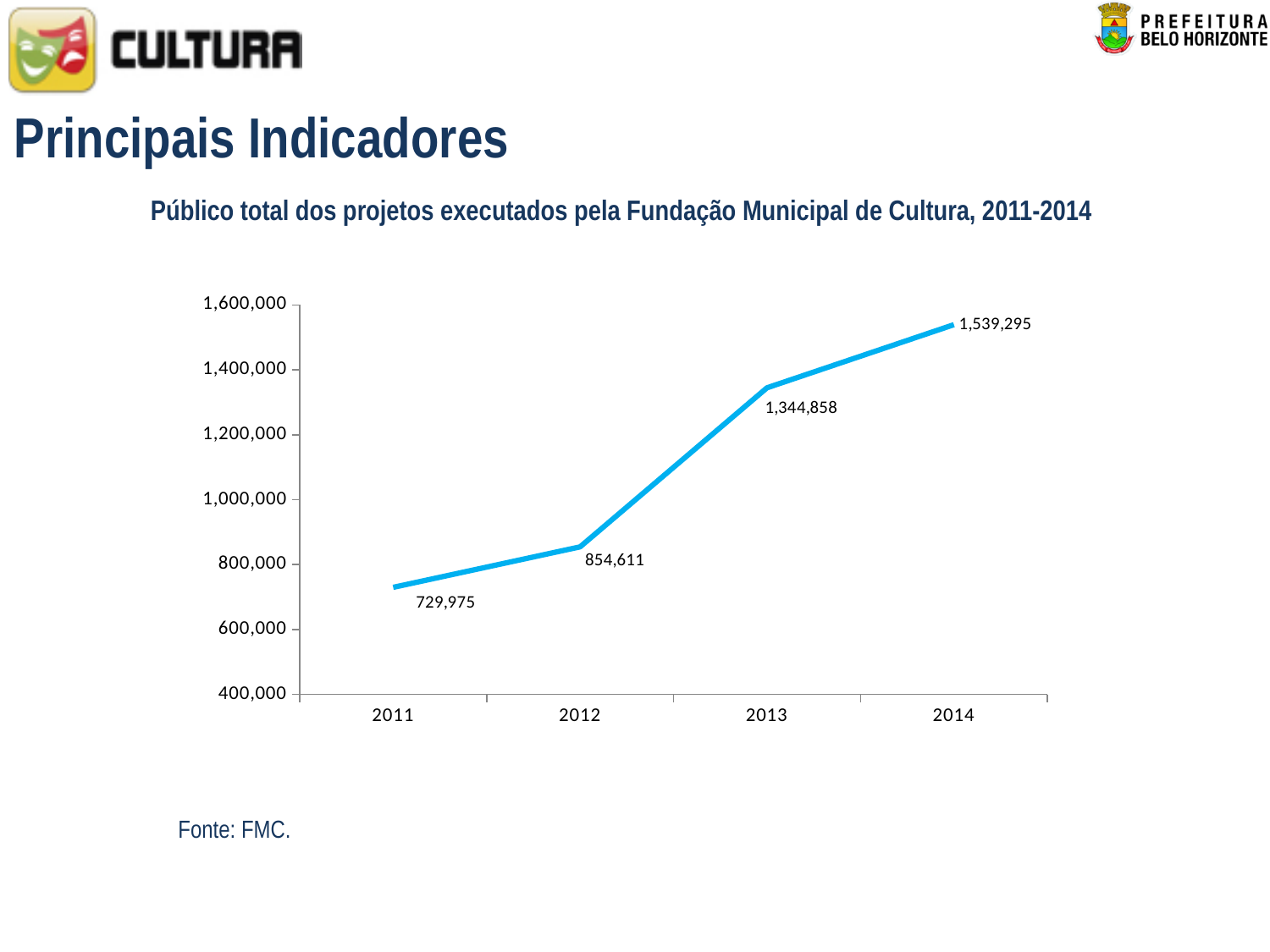
Is the value for 2012 greater or less than 1,000,000? less What kind of chart is shown on the slide? line chart Which year has the highest value? 2014 How many years are plotted on the chart? 4 Which is larger, the value for 2012 or the value for 2013? 2013 What is the value for 2011? 729,975 Which year has the lowest value? 2011 What is the value for 2013? 1,344,858 What is the difference between the values for 2013 and 2012? 490,247 What is the difference between the values for 2014 and 2013? 194,437 Do the values rise or fall from 2011 to 2014? rise What is the value for 2014? 1,539,295